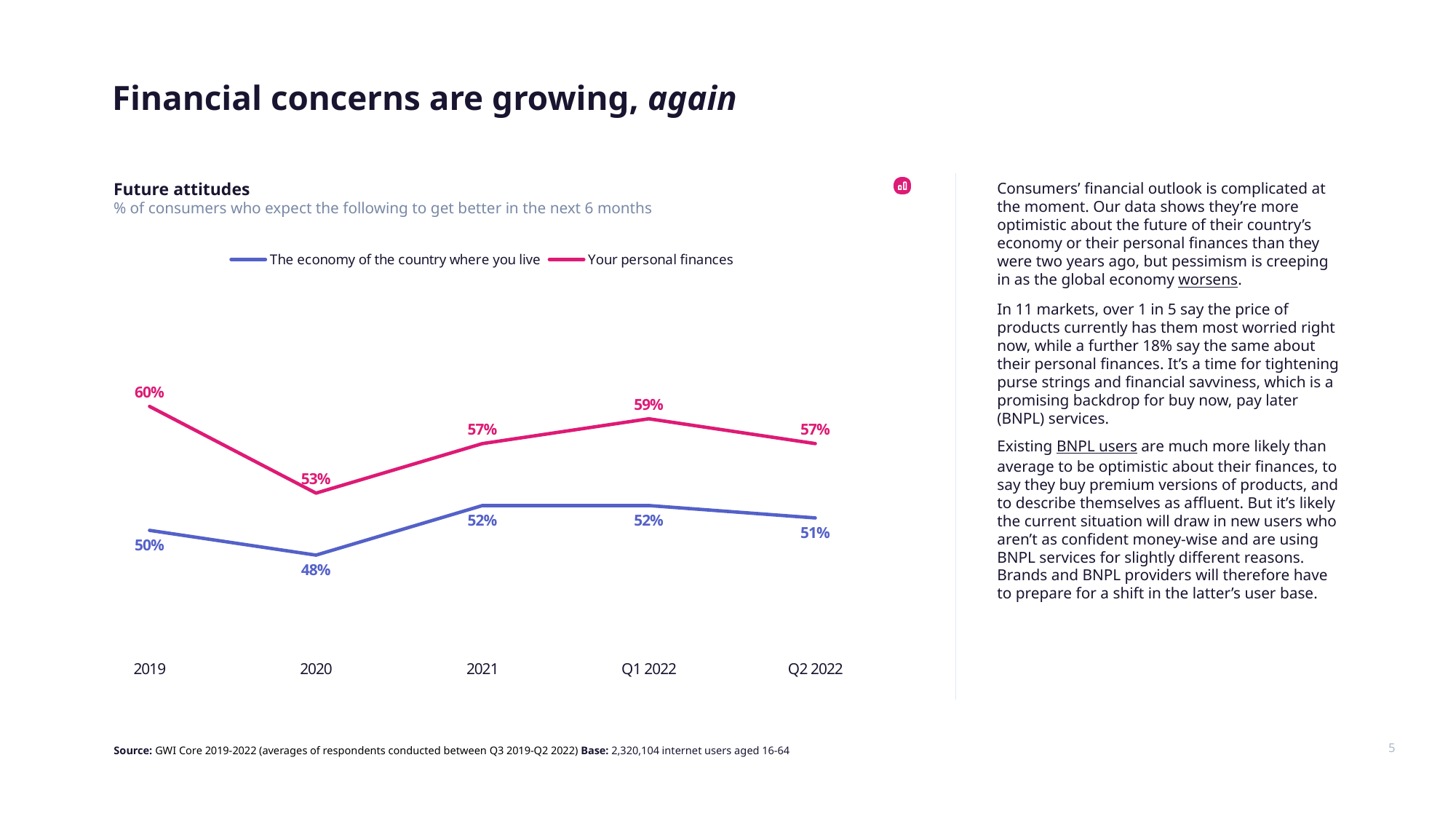
What is the value for 'The economy of the country where you live' in 2020? 48% What kind of chart is shown on the slide? Line chart What is the difference between 'Your personal finances' and 'The economy of the country where you live' in 2019? 10% In which period is 'Your personal finances' lowest? 2020 How many time periods are shown on the x axis? 5 In which period is 'Your personal finances' highest? 2019 How many series does the legend list? 2 What is the value for 'Your personal finances' in 2019? 60% What is the value for 'The economy of the country where you live' in Q2 2022? 51% What is the value for 'Your personal finances' in Q1 2022? 59% Does 'The economy of the country where you live' rise or fall from 2020 to 2021? Rise Which series has the higher value in 2021? Your personal finances